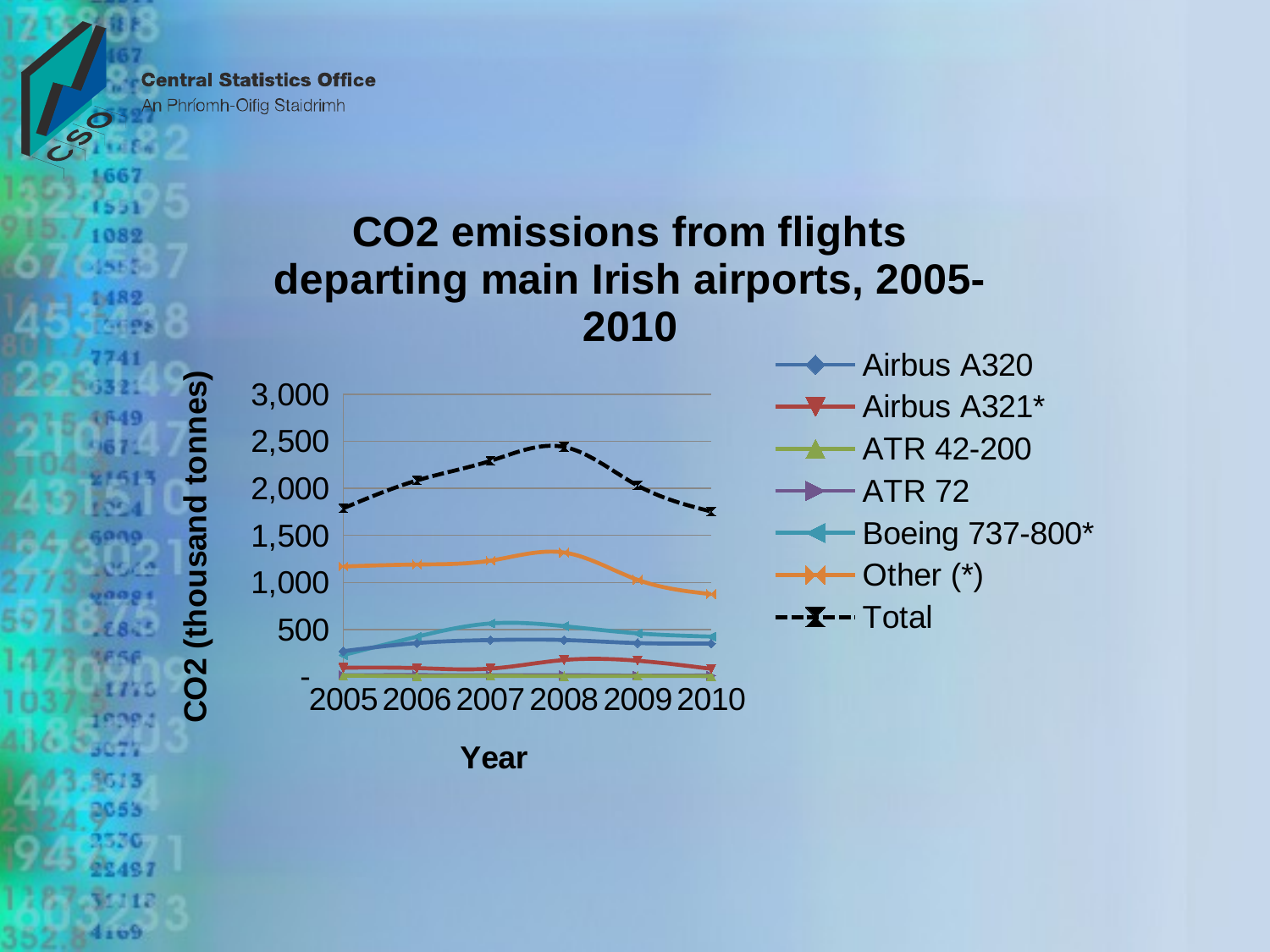
Which series has the highest values across all years? Total Which series is larger in 2008, Other (*) or Boeing 737-800*? Other (*) How many series does the legend list? 7 How many years are plotted along the x axis? 6 In which year does the Total series reach its highest value? 2008 Is the value for Other (*) in 2008 greater or less than 1,000? greater Is the value for Total in 2010 greater or less than 2,000? less Does the Total series rise or fall between 2008 and 2010? fall What is the label on the y axis of the chart? CO2 (thousand tonnes) What kind of chart is shown on the slide? line chart Is the value for Total in 2005 greater or less than 1,500? greater